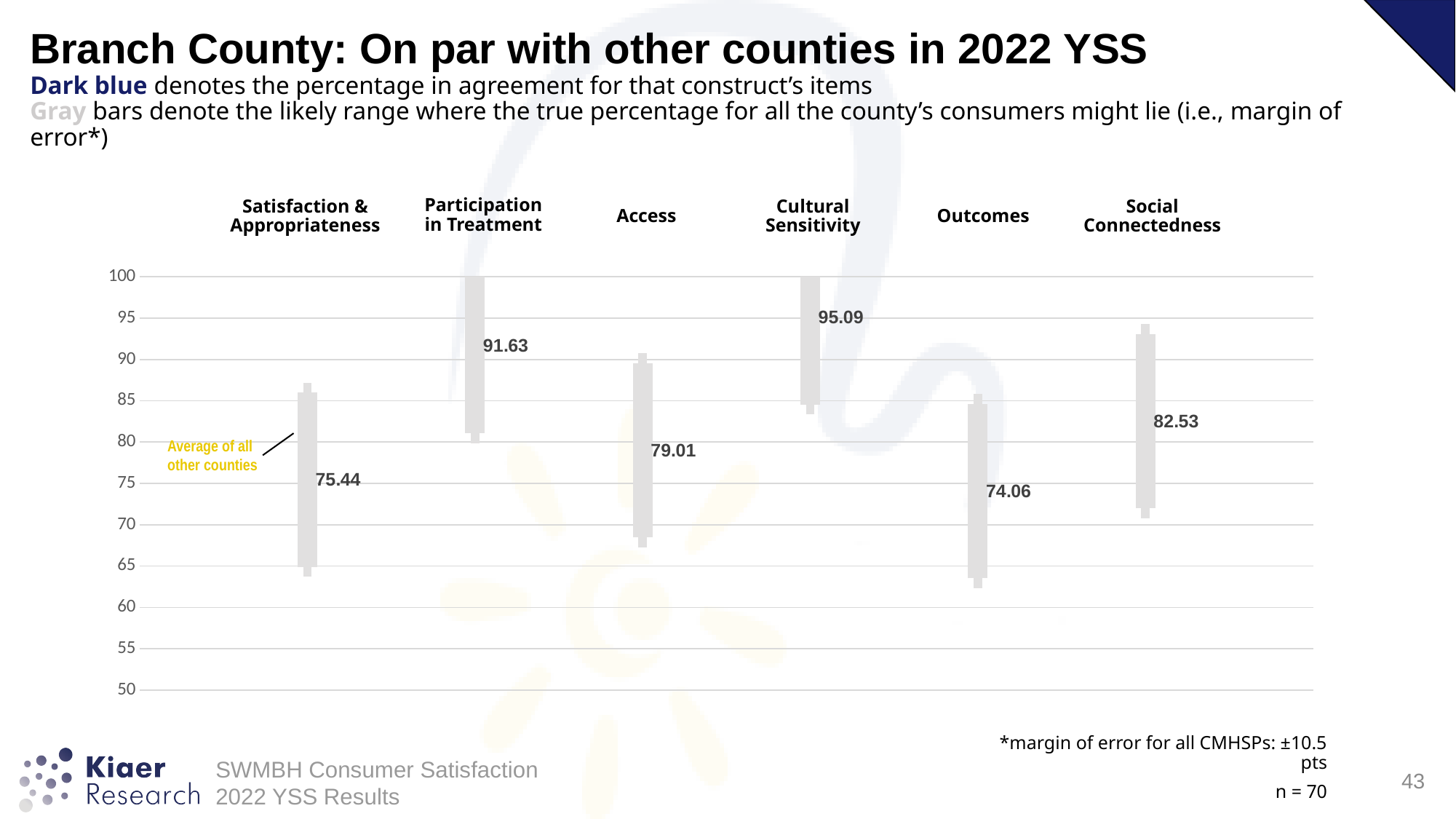
Which is larger, the value for Access or the value for Outcomes? Access What is the value for Cultural Sensitivity? 95.09 What is the difference between the values for Participation in Treatment and Access? 12.62 Which construct has the highest value? Cultural Sensitivity According to the slide, what do the gray bars denote? The likely range where the true percentage for all the county's consumers might lie (margin of error) Which construct has the lowest value? Outcomes How many constructs are shown on the chart? 6 What is the value for Outcomes? 74.06 What is the value for Satisfaction & Appropriateness? 75.44 What is the value for Social Connectedness? 82.53 What is the difference between the values for Cultural Sensitivity and Outcomes? 21.03 What is the value for Participation in Treatment? 91.63